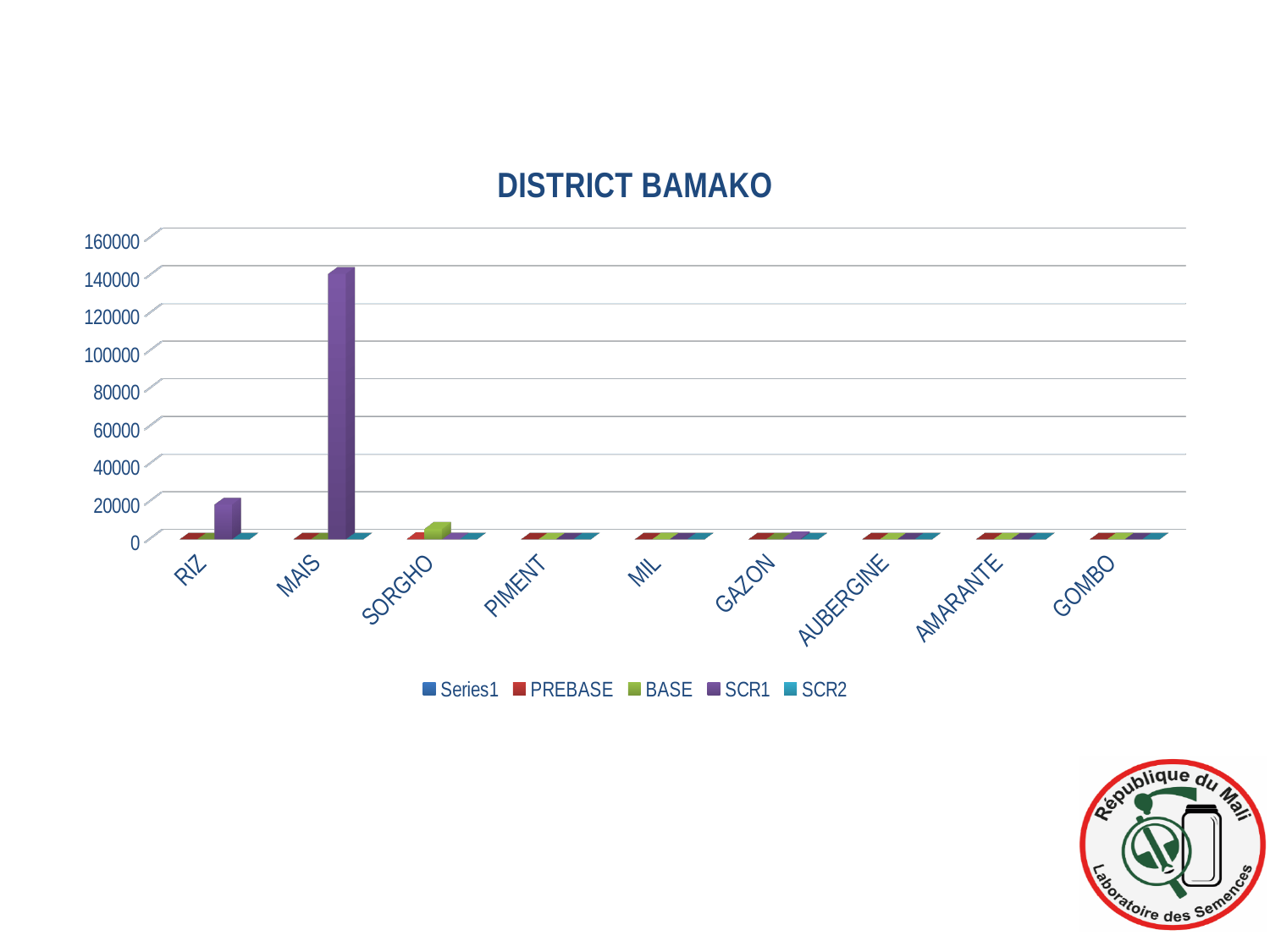
Which is larger, the SCR1 value for MAIS or the SCR1 value for RIZ? MAIS Is the SCR1 value for MAIS greater or less than 120000? greater What is the title of the chart? DISTRICT BAMAKO How many categories are shown on the x axis of the chart? 9 What is the highest value shown on the y axis? 160000 What is the last category on the x axis? GOMBO What kind of chart is shown on the slide? bar chart Is the BASE value for SORGHO greater or less than 20000? less Which is larger, the SCR1 value for RIZ or the BASE value for SORGHO? SCR1 value for RIZ Which category has the highest SCR1 value? MAIS Is the SCR1 value for RIZ greater or less than 40000? less How many series does the legend list? 5